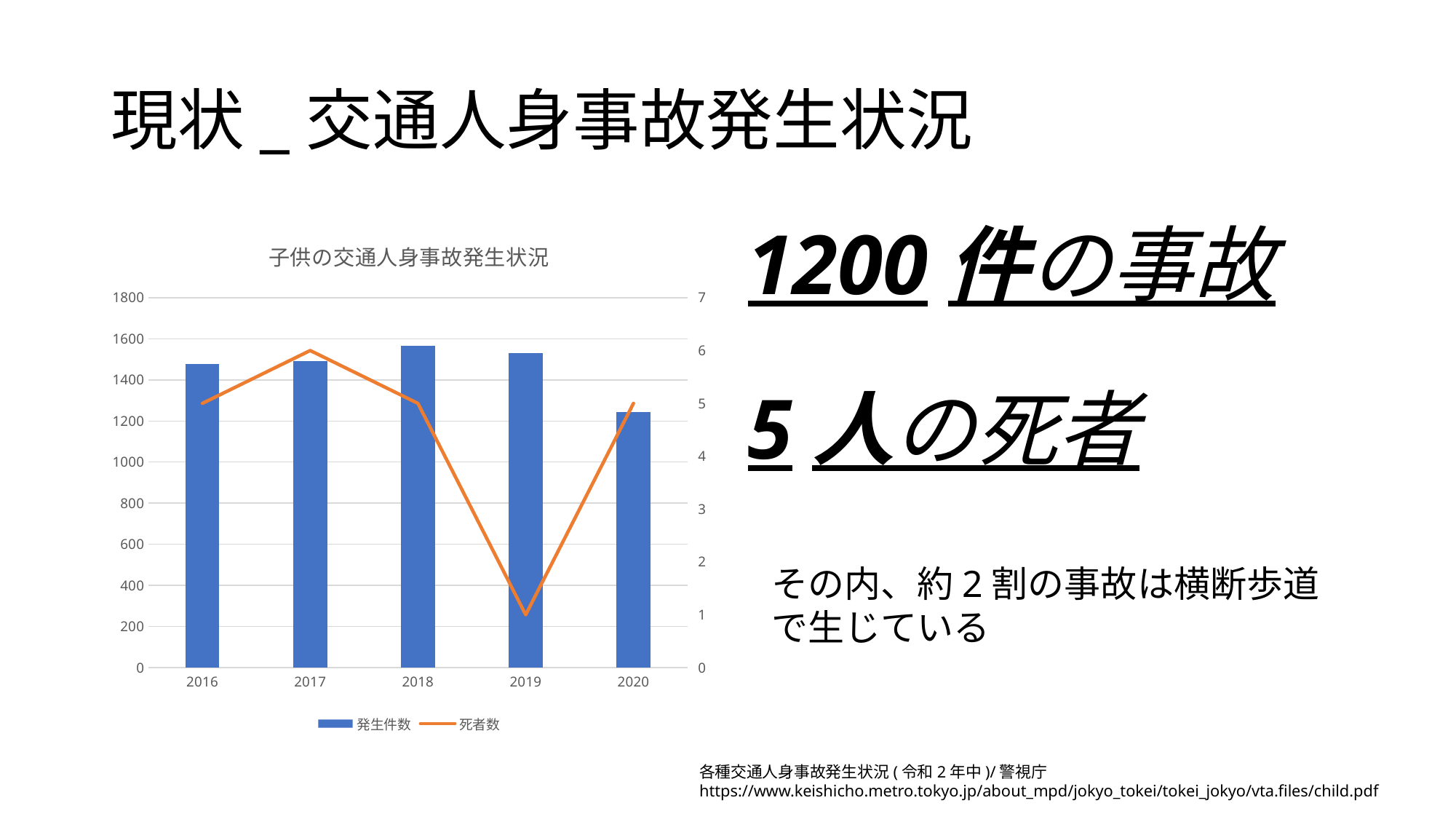
In which year is 死者数 lowest? 2019 What is the value of 死者数 for 2017? 6 How many series does the chart legend list? 2 What is the title of the chart on the slide? 子供の交通人身事故発生状況 How many years are shown on the x axis of the chart? 5 Is the value of 発生件数 for 2018 greater or less than 1400? greater Which series is drawn as a line in the chart? 死者数 Is the value of 発生件数 for 2020 greater or less than 1400? less In which year is 発生件数 lowest? 2020 What is the value of 死者数 for 2019? 1 What kind of chart is shown on the slide? Combination bar and line chart In which year is 死者数 highest? 2017